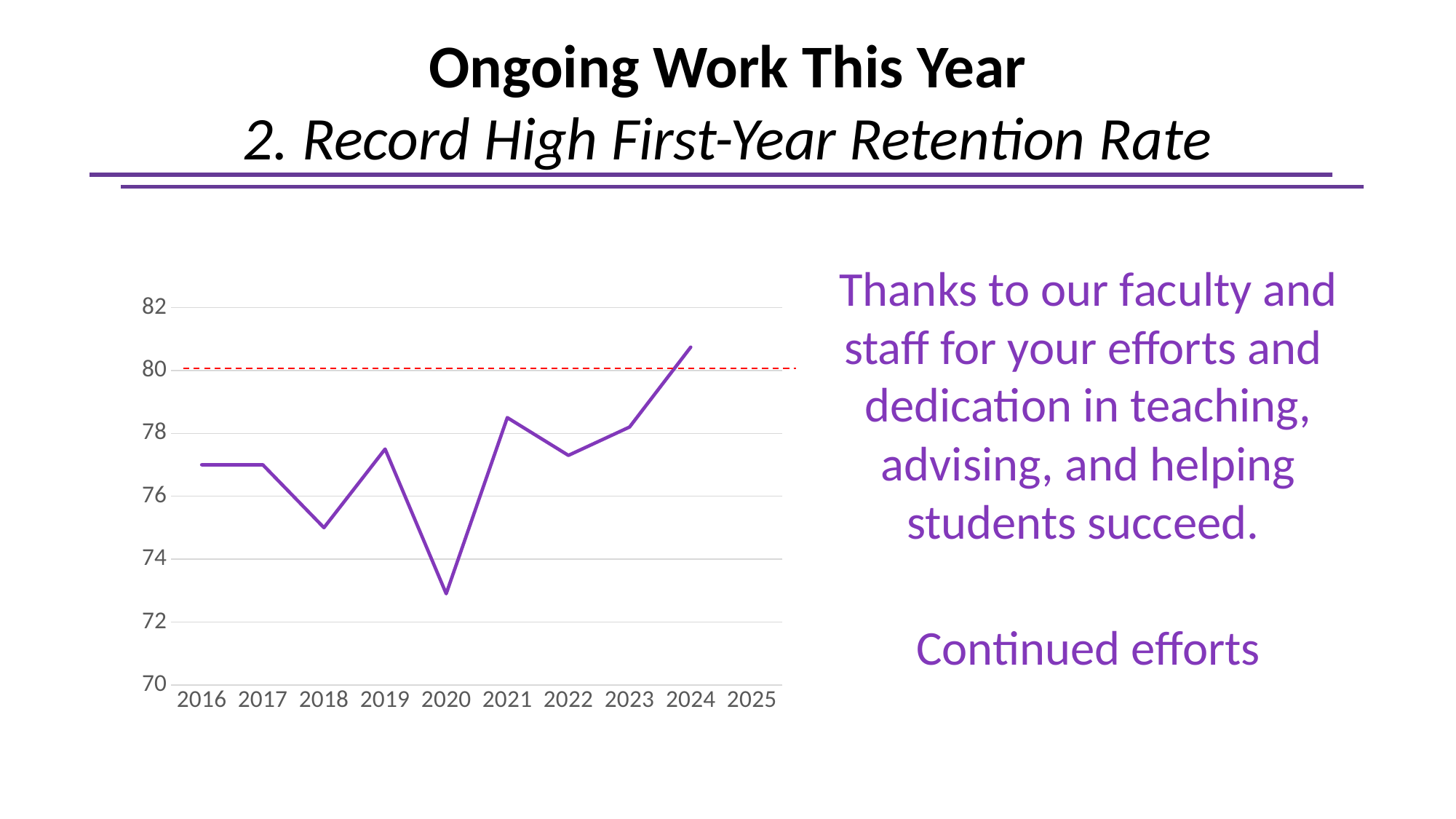
How many year labels are shown on the x axis of the chart? 10 Do the plotted values rise or fall from 2020 to 2024? rise Which year has the lowest plotted value on the chart? 2020 Is the value for 2024 greater or less than 80? greater Is the value for 2018 greater or less than 76? less Is the value for 2021 greater or less than 78? greater Which year has the highest plotted value on the chart? 2024 Which year has the larger value, 2018 or 2019? 2019 What kind of chart is shown on the slide? line chart At what value on the y axis is the red dashed horizontal line drawn? 80 Which year has the larger value, 2021 or 2022? 2021